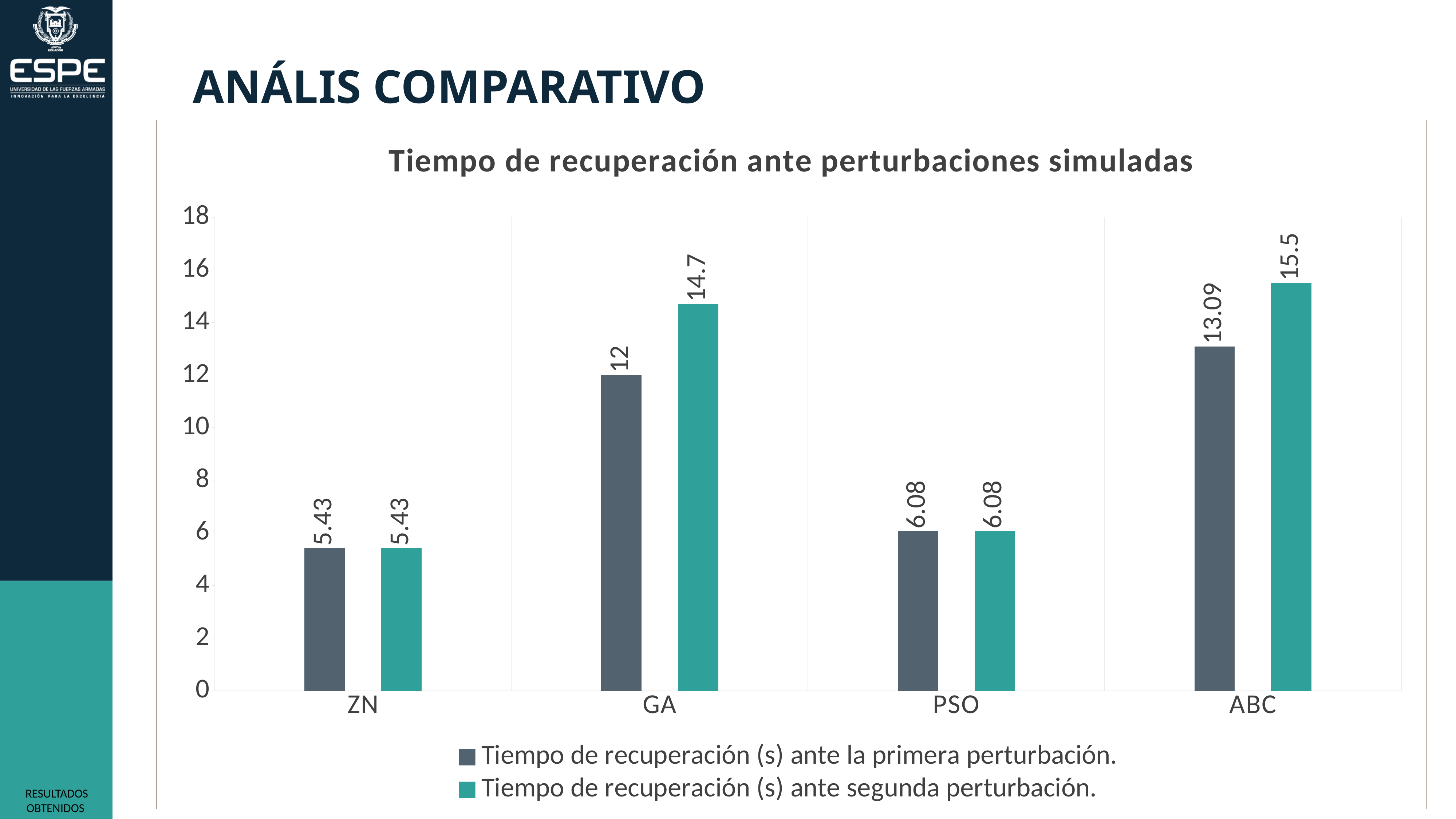
What kind of chart is shown on the slide? Bar chart What is the recovery time for GA under the first perturbation? 12 What is the difference between the second and first perturbation recovery times for GA? 2.7 What is the recovery time for ABC under the second perturbation? 15.5 What is the difference between the second and first perturbation recovery times for ABC? 2.41 How many categories are shown on the x axis? 4 Is the second perturbation recovery time for GA greater or less than 14? greater Which category has the highest recovery time under the second perturbation? ABC Which is larger: the first perturbation recovery time for GA or for ABC? ABC Which category has the lowest recovery time under the first perturbation? ZN What is the recovery time for PSO under the first perturbation? 6.08 How many series does the legend list? 2